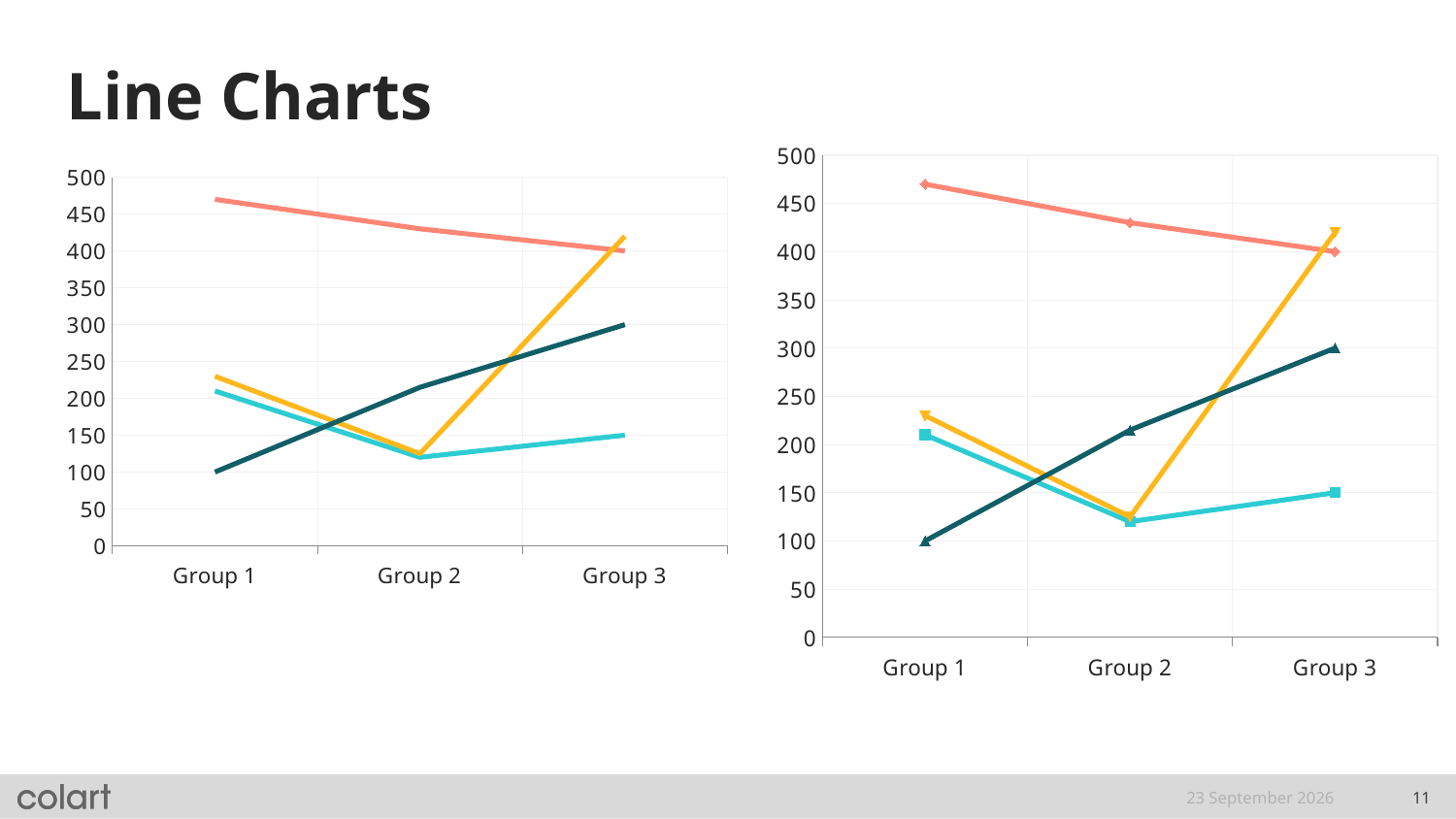
In the left chart, is the value of the pink line at Group 1 greater or less than 450? greater In the left chart, is the value of the orange line at Group 2 greater or less than 200? less In the right chart, is the value of the dark teal line at Group 1 greater or less than 150? less How many categories are shown on the x axis of the right chart? 3 In the left chart, which line has the lowest value at Group 3? the light blue line In the right chart, at Group 3, which is larger: the orange line or the dark teal line? the orange line In the left chart, does the pink line rise or fall from Group 1 to Group 3? fall What kind of chart is the left chart? line chart In the right chart, which line has the lowest value at Group 1? the dark teal line In the right chart, does the dark teal line rise or fall from Group 1 to Group 3? rise In the left chart, which line has the highest value at Group 1? the pink line